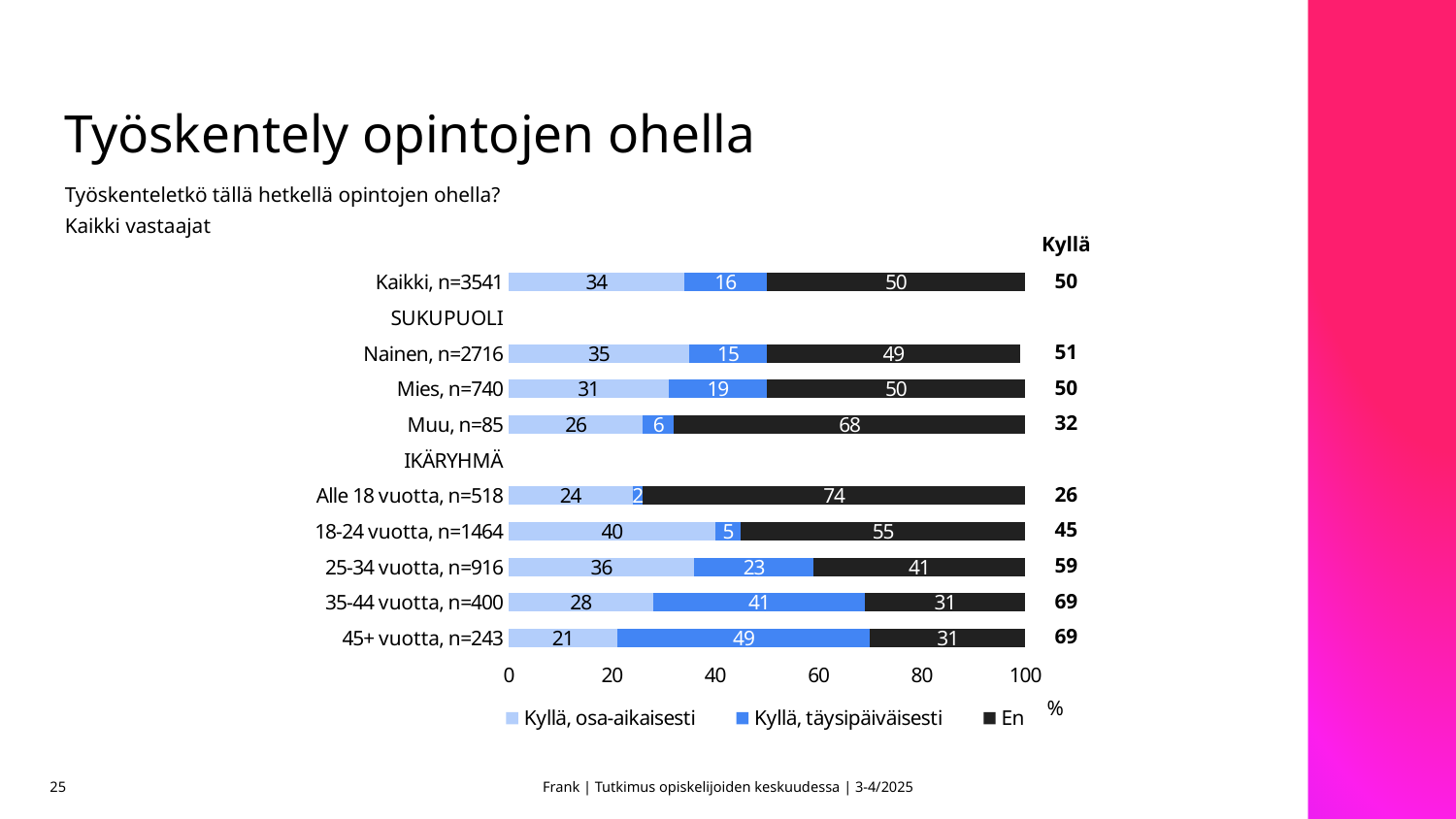
What is the value of "En" for "Alle 18 vuotta, n=518"? 74 What is the title of the chart on the slide? Työskentely opintojen ohella Which is larger: the "Kyllä, osa-aikaisesti" value for "18-24 vuotta, n=1464" or for "35-44 vuotta, n=400"? 18-24 vuotta, n=1464 What is the value of "Kyllä, osa-aikaisesti" for "Kaikki, n=3541"? 34 What is the "Kyllä" total shown for "25-34 vuotta, n=916"? 59 Which category has the highest "En" value? Alle 18 vuotta, n=518 What kind of chart is shown on the slide? Stacked bar chart What is the value of "Kyllä, täysipäiväisesti" for "45+ vuotta, n=243"? 49 Which category has the lowest "Kyllä, täysipäiväisesti" value? Alle 18 vuotta, n=518 What is the difference between the "En" values for "Muu, n=85" and "Mies, n=740"? 18 How many respondent groups (bars) are plotted in the chart? 9 How many series does the legend list? 3